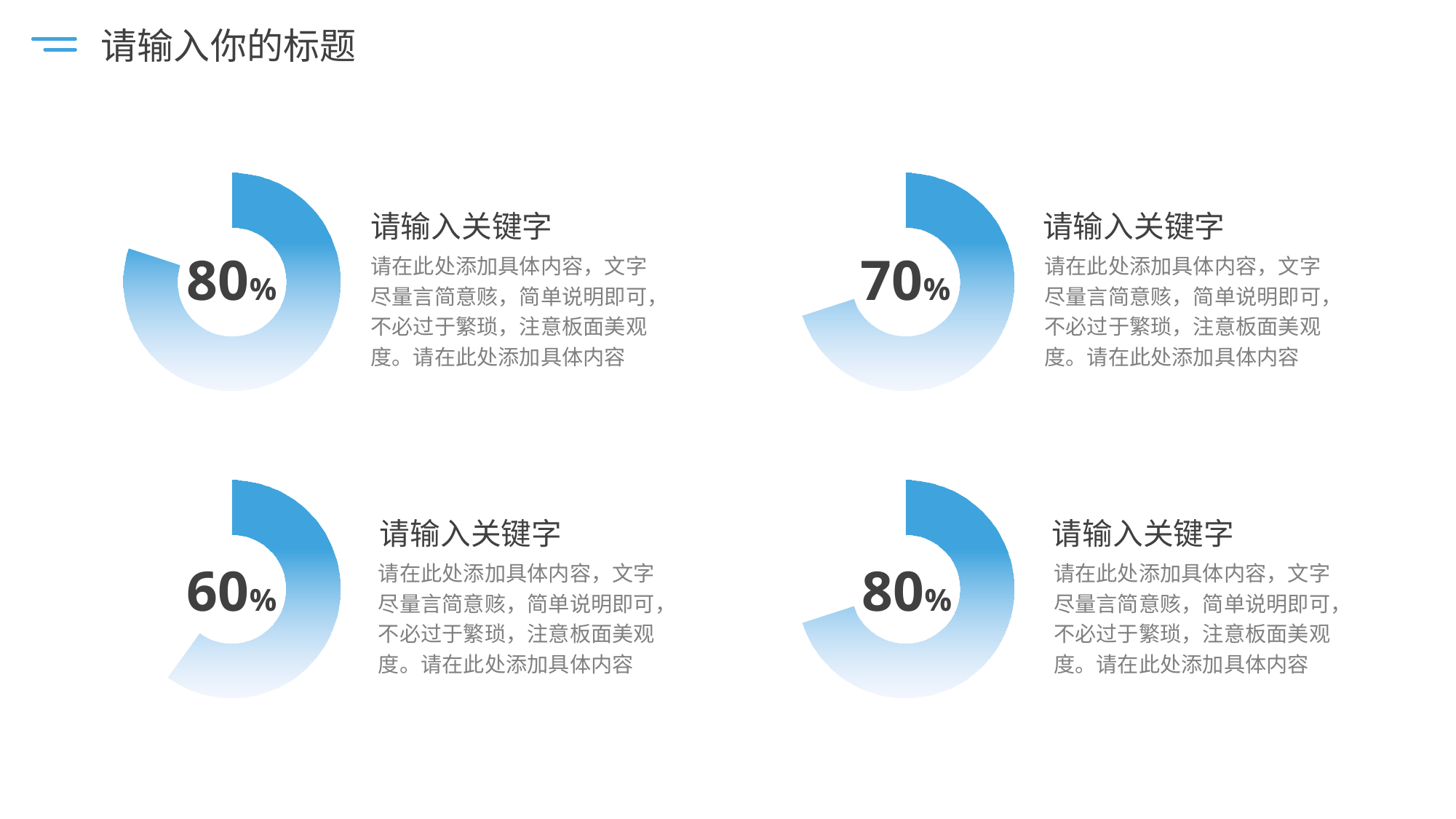
What percentage is shown in the bottom-left donut chart? 60% Is the percentage in the bottom-left donut chart greater or less than 70%? less What kind of chart is used for each of the four figures on the slide? Donut chart What colour are the filled portions of the donut charts? Blue Which is larger, the percentage in the top-left donut chart or the top-right donut chart? Top-left (80%) What percentage is shown in the bottom-right donut chart? 80% How many donut charts are on the slide? 4 What percentage is shown in the top-right donut chart? 70% What is the difference between the bottom-right donut chart's percentage and the top-right donut chart's percentage? 10% What is the difference between the top-right donut chart's percentage and the bottom-left donut chart's percentage? 10% Which donut chart shows the lowest percentage? Bottom-left (60%) What percentage is shown in the top-left donut chart? 80%